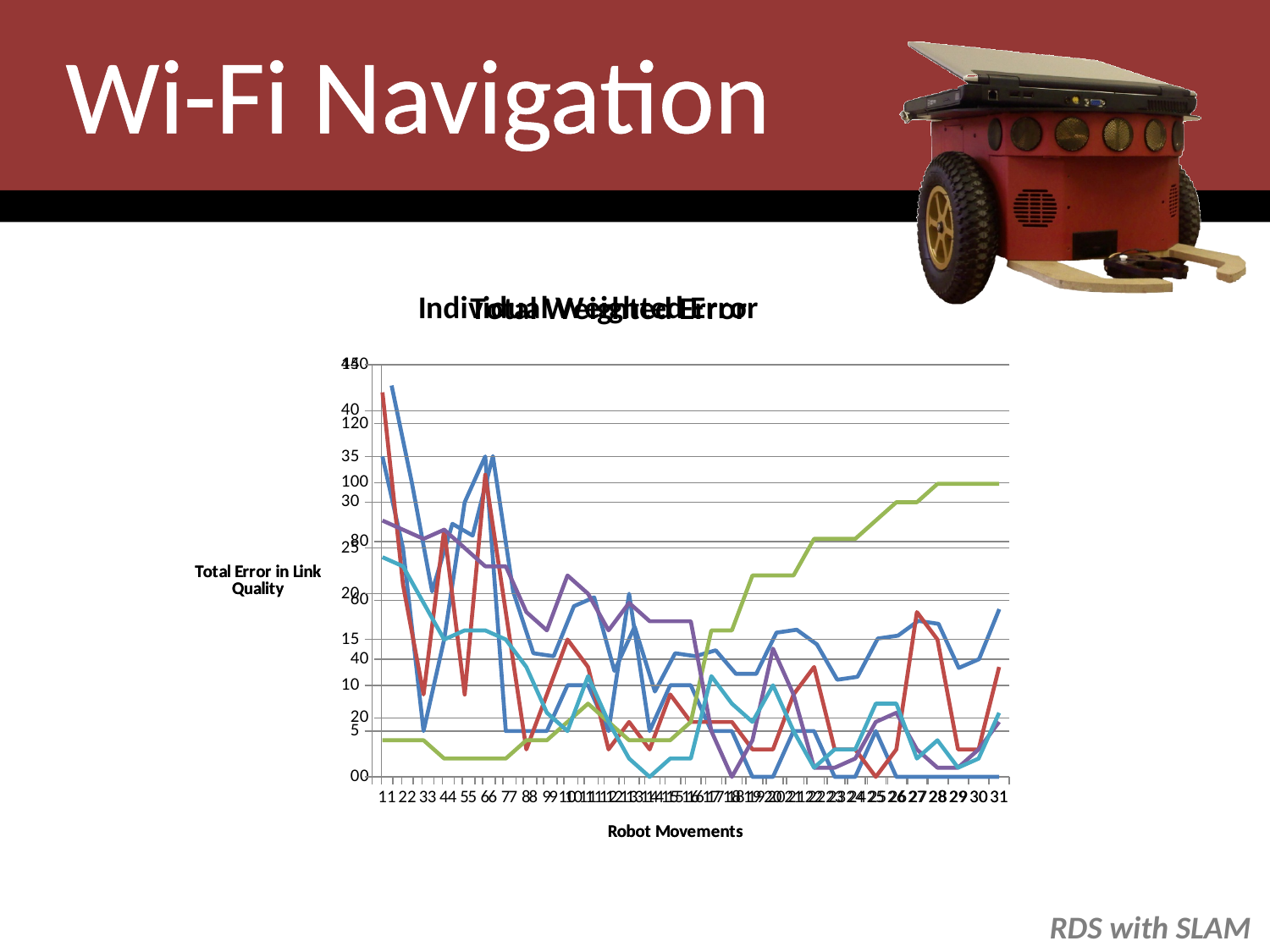
What is the title of the x axis of the chart? Robot Movements How many robot movements are labelled along the x axis of the chart? 31 What kind of chart is shown on the slide? line chart Does the green line in the chart generally rise or fall as the robot movements increase along the x axis? rise What is the title of the y axis of the chart? Total Error in Link Quality